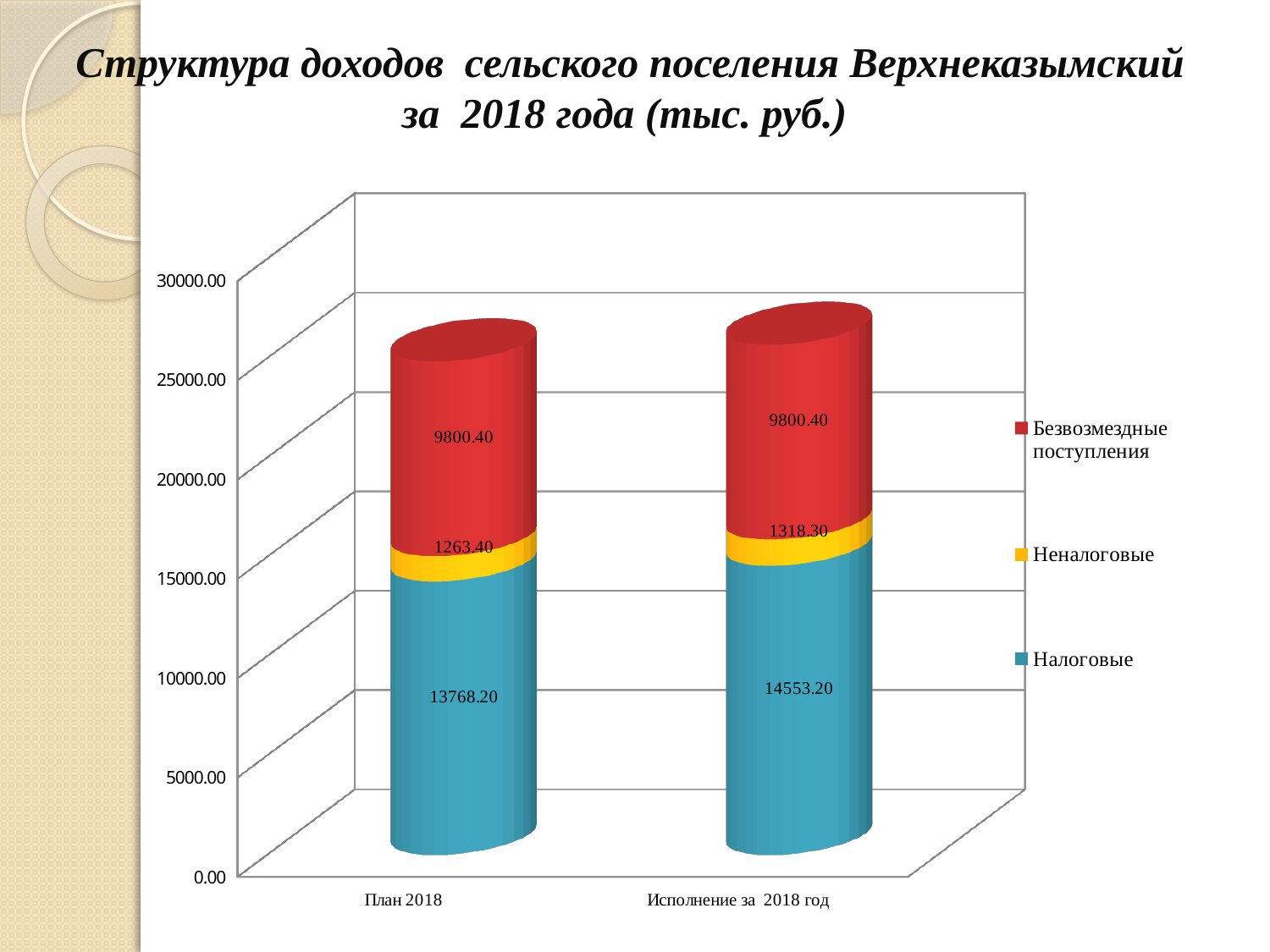
Which series is shown in red in the legend? Безвозмездные поступления What is the difference between the Неналоговые values for Исполнение за 2018 год and План 2018? 54.90 What type of chart is shown on the slide? stacked bar chart How many categories are shown on the x axis? 2 What is the value of Налоговые for План 2018? 13768.20 What is the value of Неналоговые for Исполнение за 2018 год? 1318.30 What is the value of Безвозмездные поступления for План 2018? 9800.40 What is the total of the stacked bar for План 2018? 24832.00 How many series does the legend list? 3 What is the value of Налоговые for Исполнение за 2018 год? 14553.20 Which category has the larger Налоговые value, План 2018 or Исполнение за 2018 год? Исполнение за 2018 год What is the difference between the Налоговые values for Исполнение за 2018 год and План 2018? 785.00